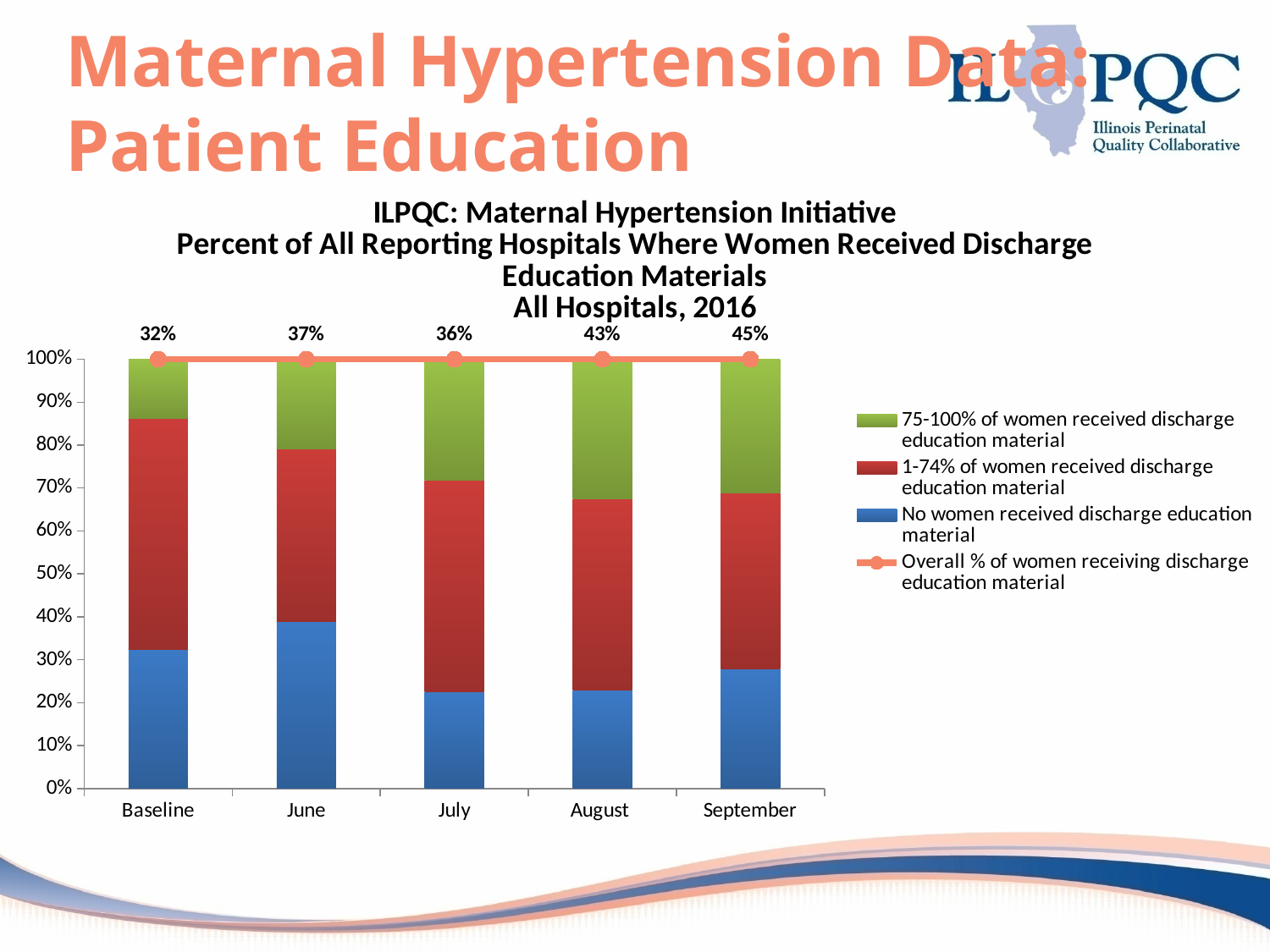
Is the share of hospitals where no women received discharge education material in June greater or less than 30%? greater What is the overall % of women receiving discharge education material in July? 36% Is the share of hospitals where no women received discharge education material in July greater or less than 30%? less What is the overall % of women receiving discharge education material at Baseline? 32% What kind of chart is this? Stacked bar chart with a line In which period is the overall % of women receiving discharge education material lowest? Baseline How many series does the legend list? 4 What is the overall % of women receiving discharge education material in September? 45% How many time periods are shown on the x axis? 5 What is the difference between the overall % of women receiving discharge education material in September and at Baseline? 13% Which is larger, the overall % of women receiving discharge education material in June or in August? August In which month is the overall % of women receiving discharge education material highest? September